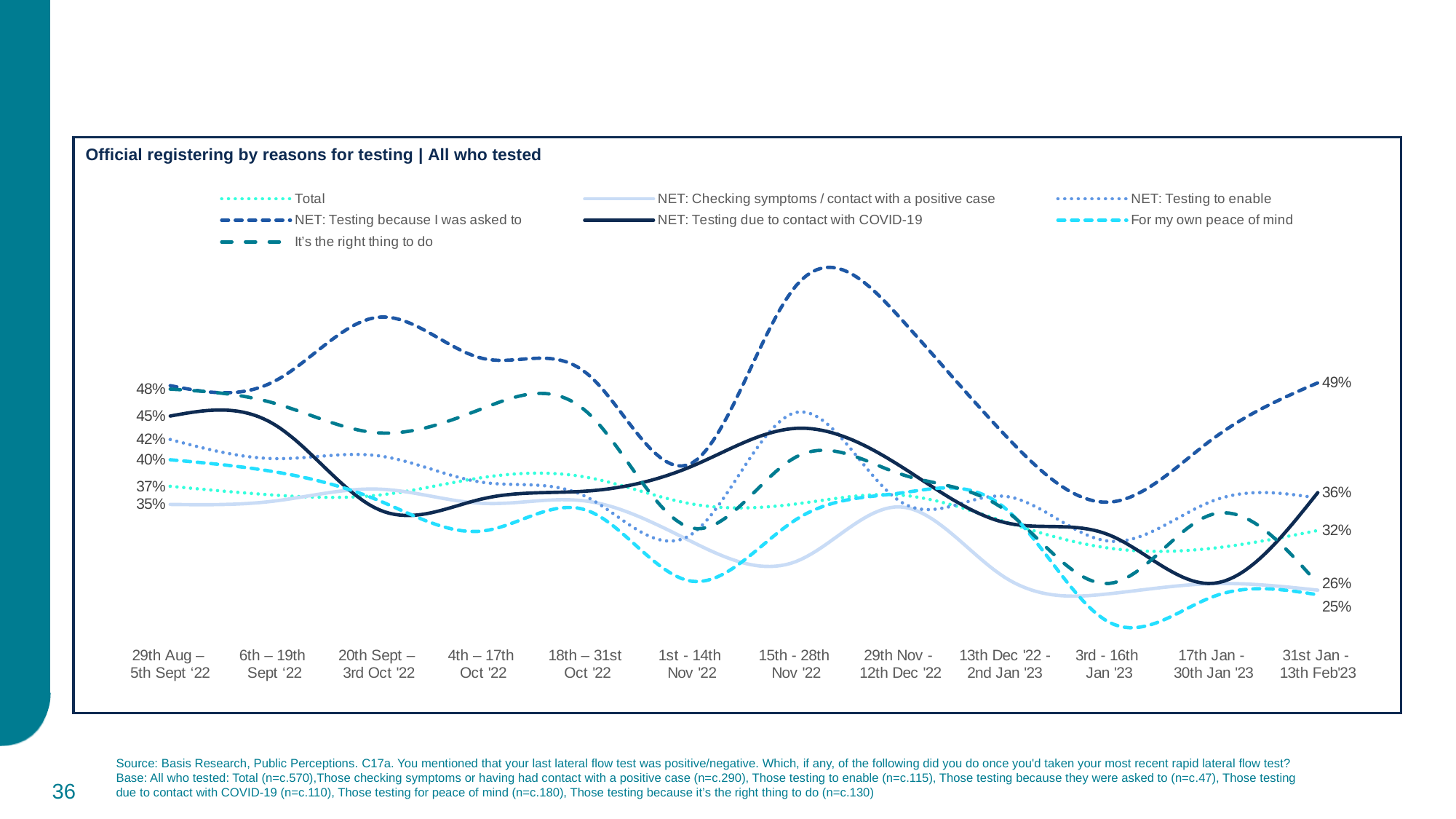
What is the value for NET: Testing because I was asked to in the 31st Jan - 13th Feb '23 period? 49% What is the value for For my own peace of mind in the 29th Aug – 5th Sept '22 period? 40% In the 29th Aug – 5th Sept '22 period, which is larger: NET: Testing to enable or NET: Checking symptoms / contact with a positive case? NET: Testing to enable What is the value for NET: Testing due to contact with COVID-19 in the 29th Aug – 5th Sept '22 period? 45% What is the title of the chart? Official registering by reasons for testing | All who tested How many time periods are shown along the x axis? 12 By how many percentage points did the Total value fall from the 29th Aug – 5th Sept '22 period to the 31st Jan - 13th Feb '23 period? 5 percentage points How many series does the legend list? 7 Which series has the lowest value in the 31st Jan - 13th Feb '23 period? For my own peace of mind Which series has the highest value in the 31st Jan - 13th Feb '23 period? NET: Testing because I was asked to What type of chart is shown on the slide? Line chart What is the value for Total in the 31st Jan - 13th Feb '23 period? 32%